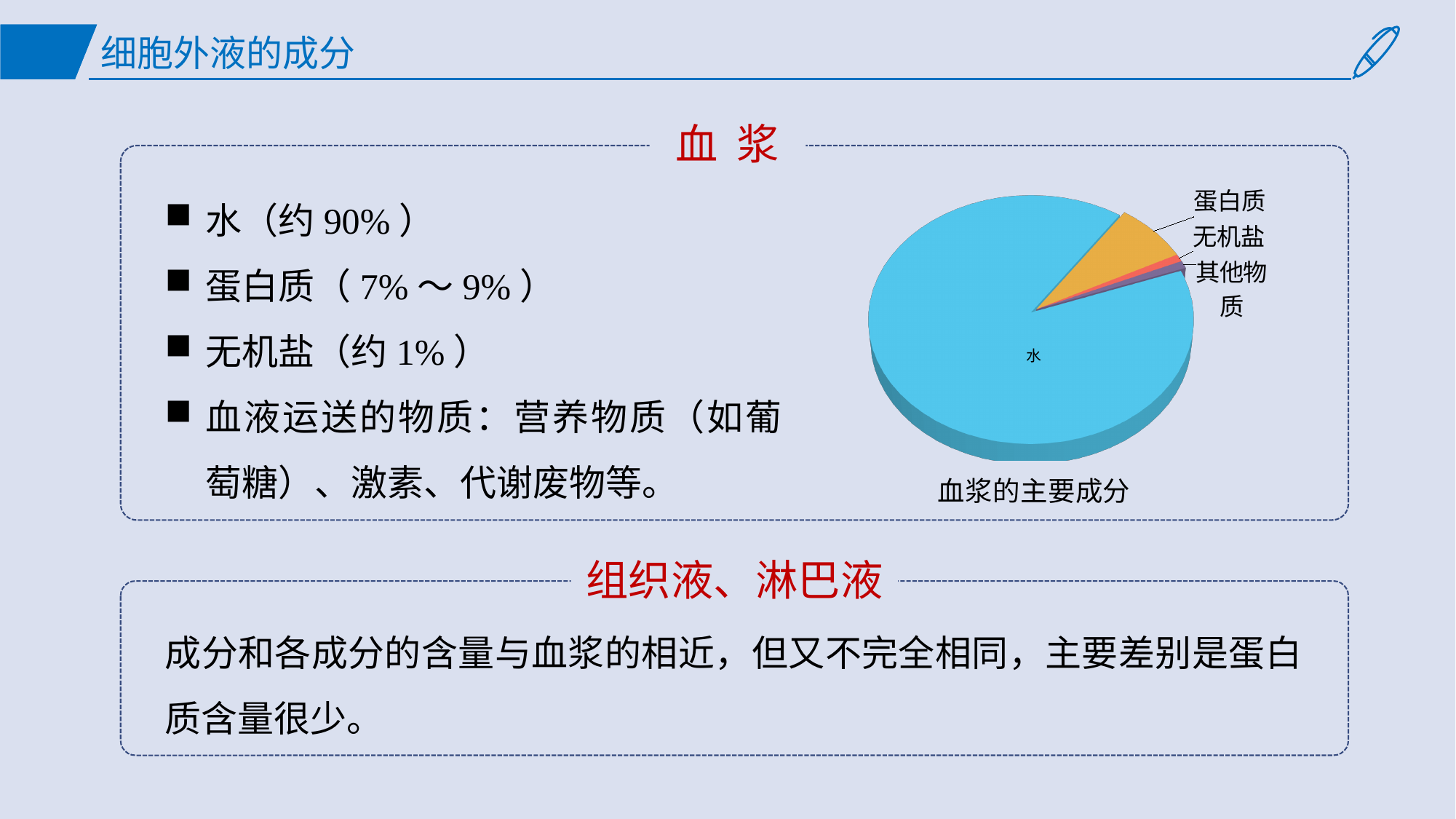
Which slice is larger in the pie chart, 蛋白质 or 无机盐? 蛋白质 Which slice is larger in the pie chart, 蛋白质 or 其他物质? 蛋白质 Which slice of the pie chart is the second largest? 蛋白质 What is the title of the pie chart? 血浆的主要成分 What kind of chart is shown on the slide? pie chart What colour is the 水 slice in the pie chart? blue Which component has the largest slice in the pie chart? 水 How many slices does the pie chart have? 4 Which slice is larger in the pie chart, 水 or 蛋白质? 水